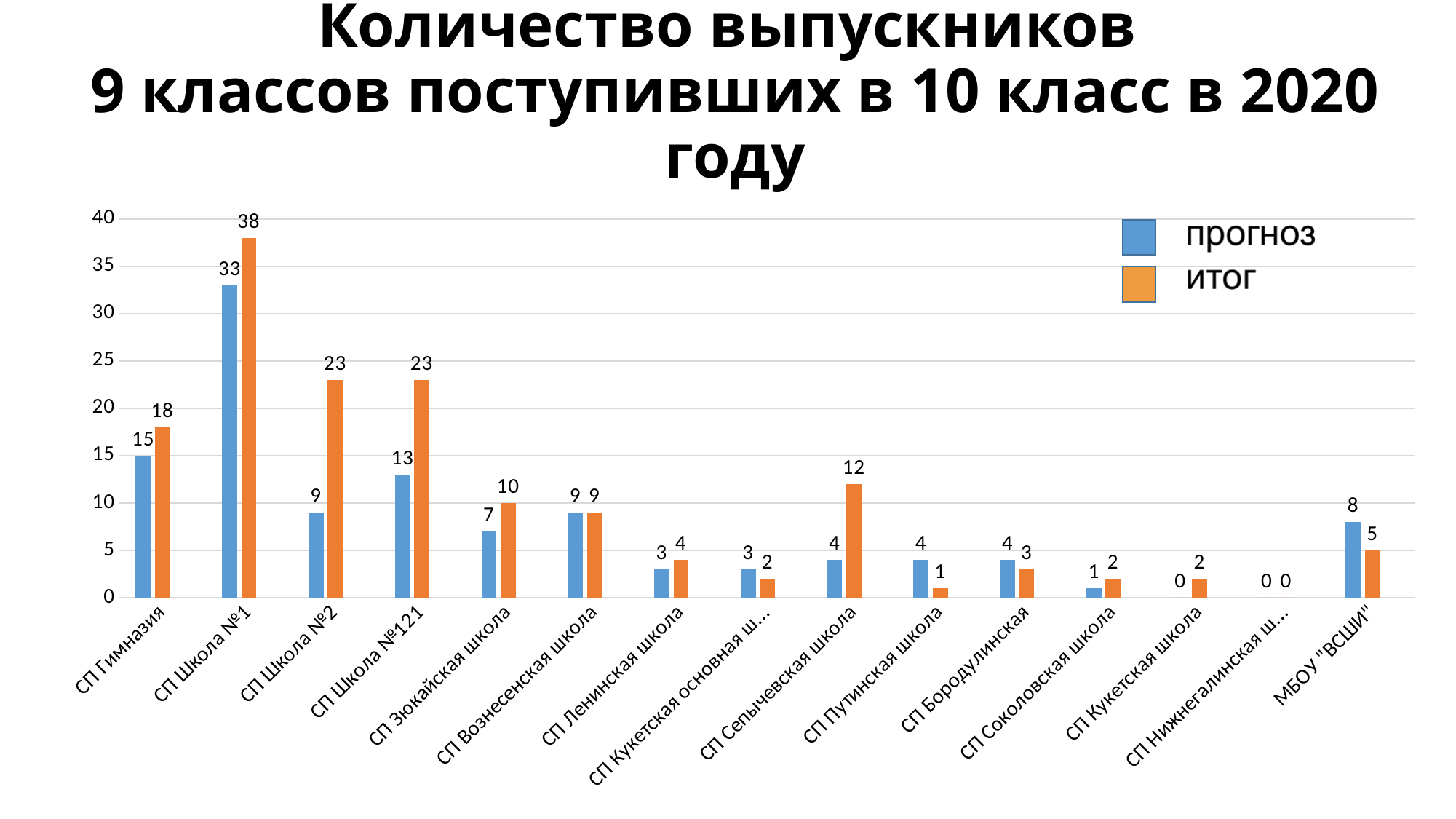
What kind of chart is shown on the slide? bar chart What is the difference between the итог and прогноз values for СП Школа №2? 14 What is the прогноз value for СП Школа №121? 13 Which is larger for СП Путинская школа: the прогноз value or the итог value? прогноз How many series does the legend list? 2 What is the итог value for СП Сепычевская школа? 12 Which is larger for МБОУ "ВСШИ": the прогноз value or the итог value? прогноз Which category has the highest итог value? СП Школа №1 How many categories are shown on the x axis? 15 What is the итог value for СП Школа №1? 38 What is the difference between the итог and прогноз values for СП Гимназия? 3 Which category has the highest прогноз value? СП Школа №1